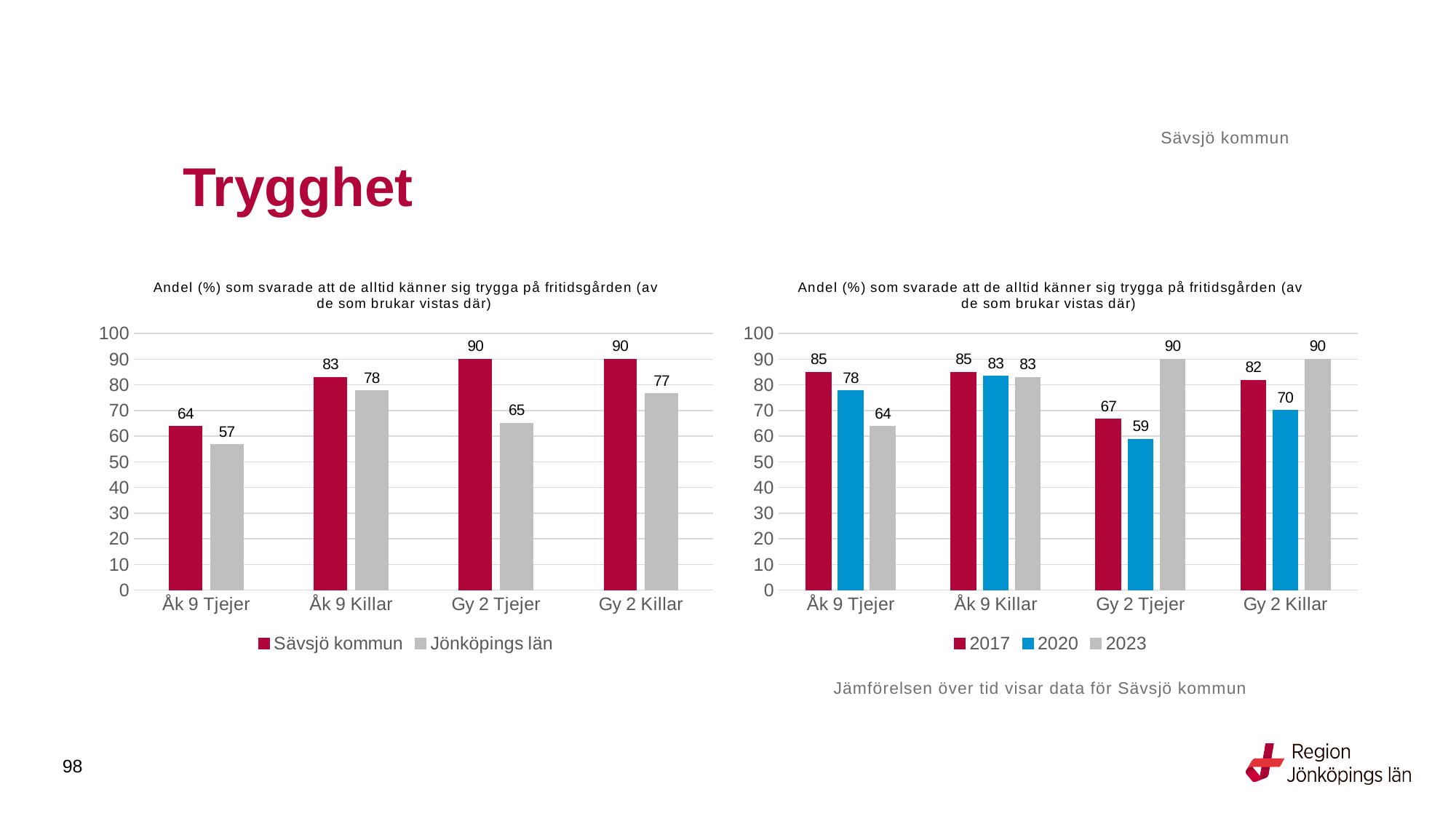
In the left chart, how many series does the legend list? 2 In the right chart, what is the difference between the 2017 and 2023 values for Åk 9 Tjejer? 21 In the right chart, what is the value for 2020 for Gy 2 Tjejer? 59 In the left chart, what is the value for Sävsjö kommun for Åk 9 Tjejer? 64 In the left chart, which category has the lowest value for Jönköpings län? Åk 9 Tjejer In the right chart, how many categories are shown on the x axis? 4 What kind of chart is the right chart? Bar chart In the right chart, is the value for 2020 for Gy 2 Killar larger or smaller than the value for 2023 for Gy 2 Killar? smaller In the right chart, what is the value for 2023 for Åk 9 Tjejer? 64 In the left chart, what is the difference between Sävsjö kommun and Jönköpings län for Gy 2 Tjejer? 25 In the right chart, which category has the lowest value for 2017? Gy 2 Tjejer In the left chart, what is the value for Jönköpings län for Gy 2 Killar? 77